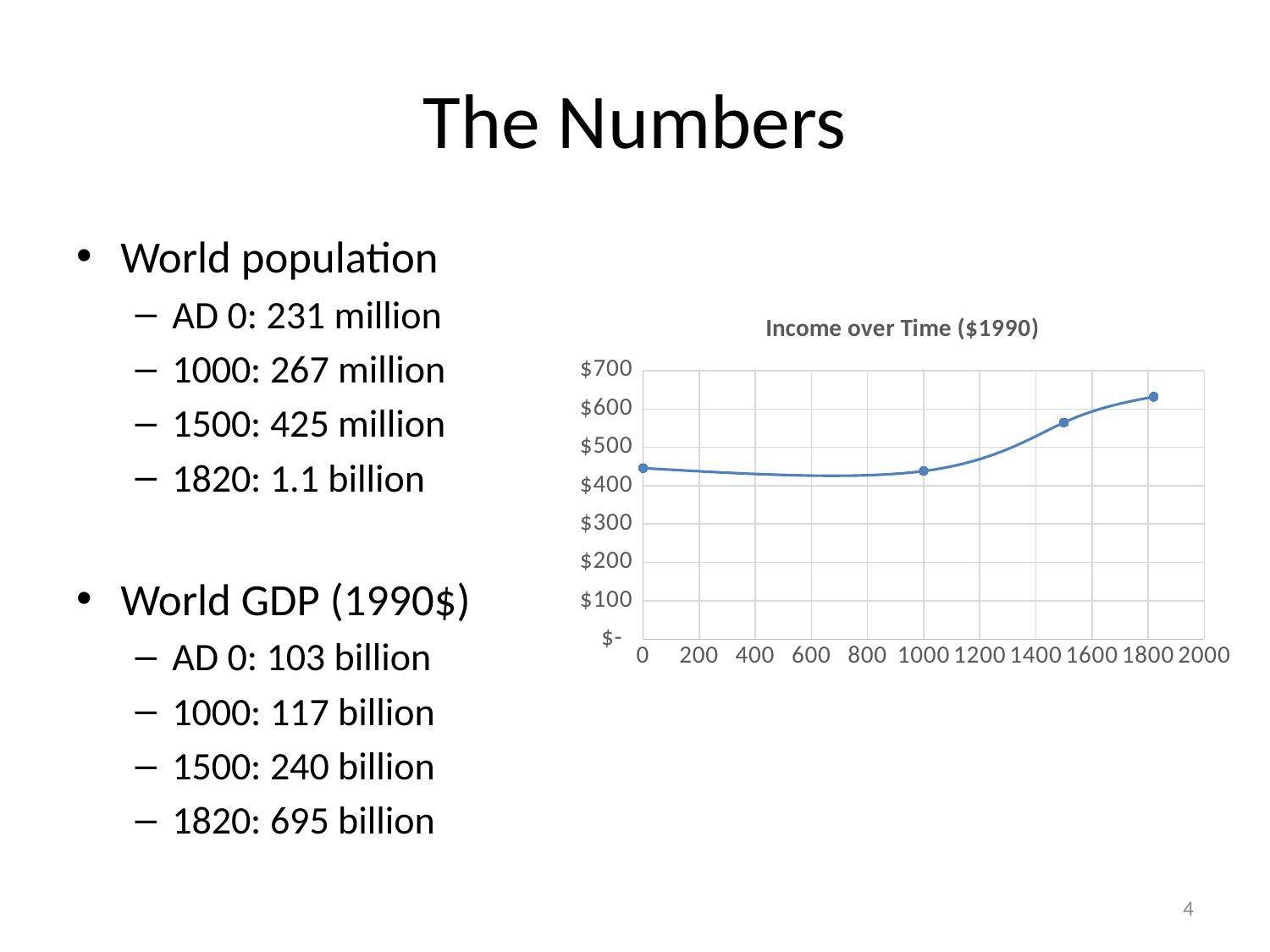
Does the income value rise or fall between year 1000 and year 1820? rise Is the income value at year 1820 greater or less than $600? greater Which year has the larger income value, 1000 or 1500? 1500 Is the income value at year 1500 greater or less than $500? greater What kind of chart is shown on the slide? line chart Is the income value at year 0 greater or less than $500? less What is the title of the chart? Income over Time ($1990) What is the highest value shown on the chart's vertical axis? $700 At which year does the chart show the highest income? 1820 Which year has the larger income value, 1500 or 1820? 1820 How many data points are plotted on the chart? 4